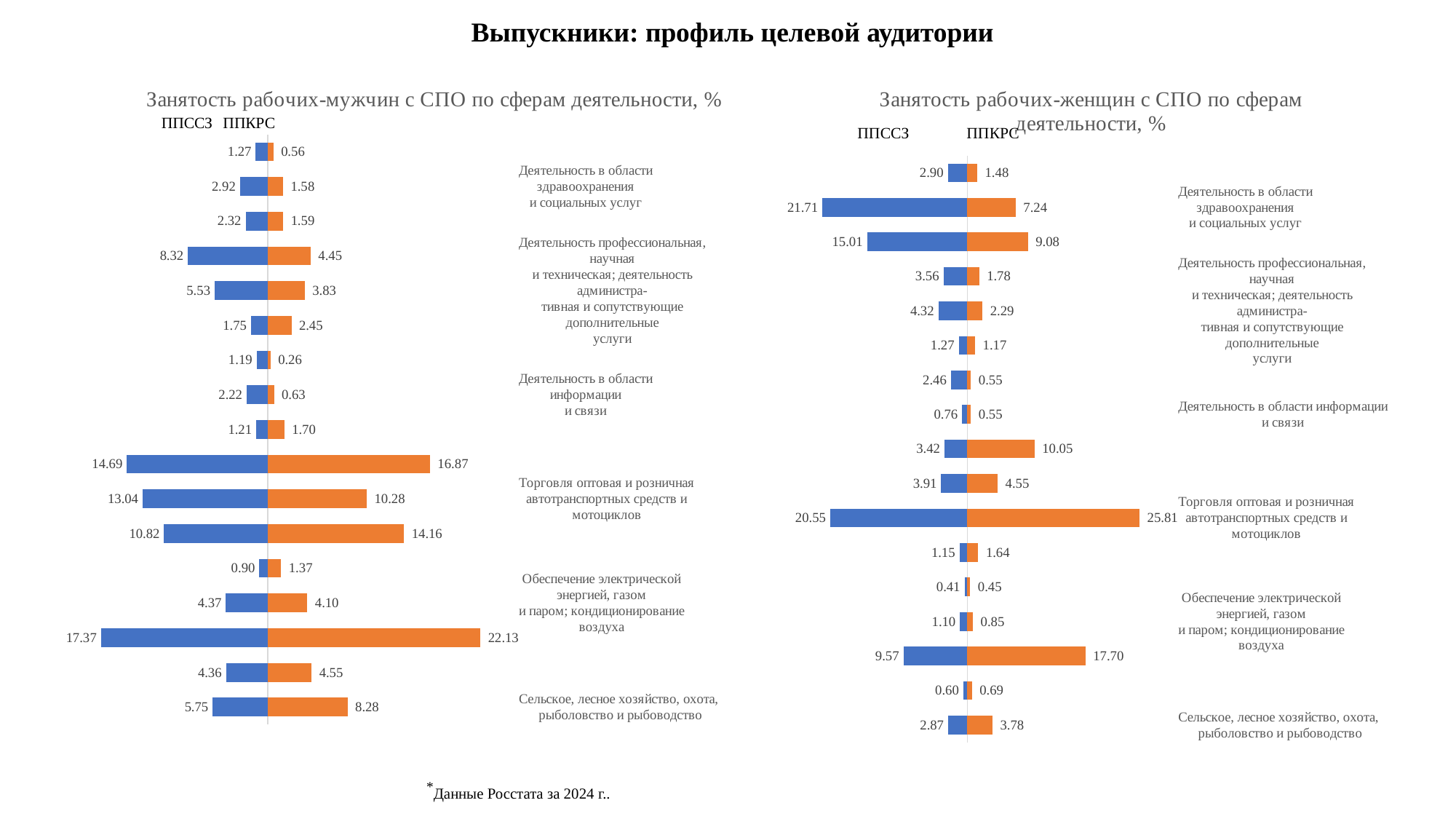
How many bars does each series have in the left chart (рабочих-мужчин)? 17 In the left chart (рабочих-мужчин), what is the lowest ППКРС value shown? 0.26 Which colour represents the ППССЗ series in both charts? blue In the left chart (рабочих-мужчин), what is the ППКРС value for Сельское, лесное хозяйство, охота, рыболовство и рыбоводство? 8.28 In the left chart (рабочих-мужчин), what is the difference between the ППКРС and ППССЗ values for Сельское, лесное хозяйство, охота, рыболовство и рыбоводство? 2.53 In the right chart (рабочих-женщин), what is the ППКРС value for Сельское, лесное хозяйство, охота, рыболовство и рыбоводство? 3.78 In the right chart (рабочих-женщин), which series has the larger value for Сельское, лесное хозяйство, охота, рыболовство и рыбоводство? ППКРС How many series does each chart show? 2 What kind of chart is used on the slide for the employment of male workers? bar chart In the left chart (рабочих-мужчин), what is the ППССЗ value for Сельское, лесное хозяйство, охота, рыболовство и рыбоводство? 5.75 In the left chart (рабочих-мужчин), what is the highest ППКРС value shown? 22.13 In the right chart (рабочих-женщин), what is the highest ППССЗ value shown? 21.71